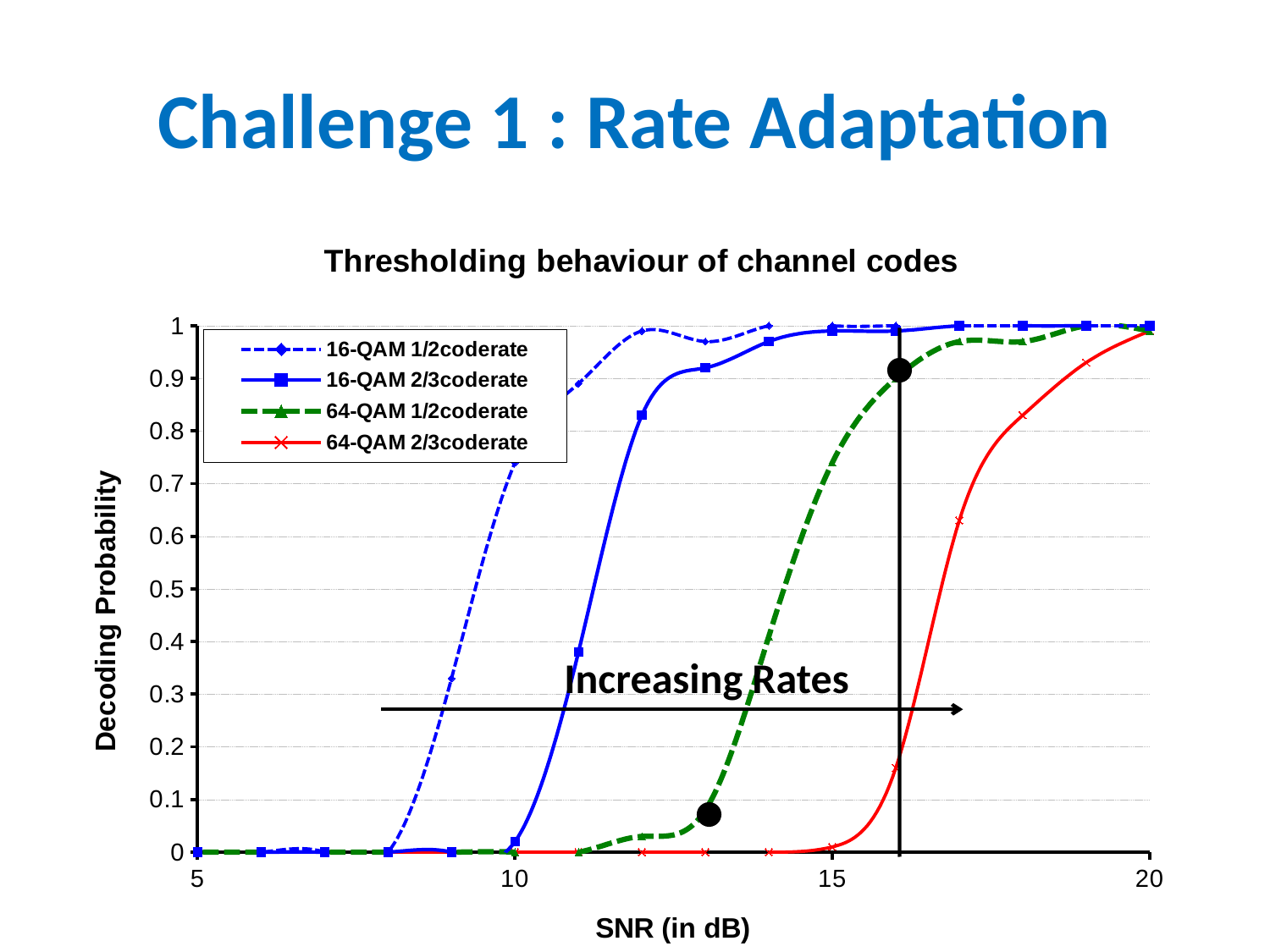
What is the title of the chart? Thresholding behaviour of channel codes Is the decoding probability for 64-QAM 1/2coderate at SNR 16 greater or less than 0.8? greater At SNR 12, which series has the higher decoding probability: 16-QAM 2/3coderate or 64-QAM 1/2coderate? 16-QAM 2/3coderate Is the decoding probability for 64-QAM 2/3coderate at SNR 15 greater or less than 0.1? less How many series does the legend list? 4 What is the label of the x axis? SNR (in dB) What kind of chart is shown on the slide? line chart At SNR 17, which series has the higher decoding probability: 64-QAM 1/2coderate or 64-QAM 2/3coderate? 64-QAM 1/2coderate Is the decoding probability for 16-QAM 2/3coderate at SNR 12 greater or less than 0.5? greater Do the decoding probability values rise or fall as SNR increases along the x axis? rise What is the decoding probability for 64-QAM 2/3coderate at SNR 5? 0